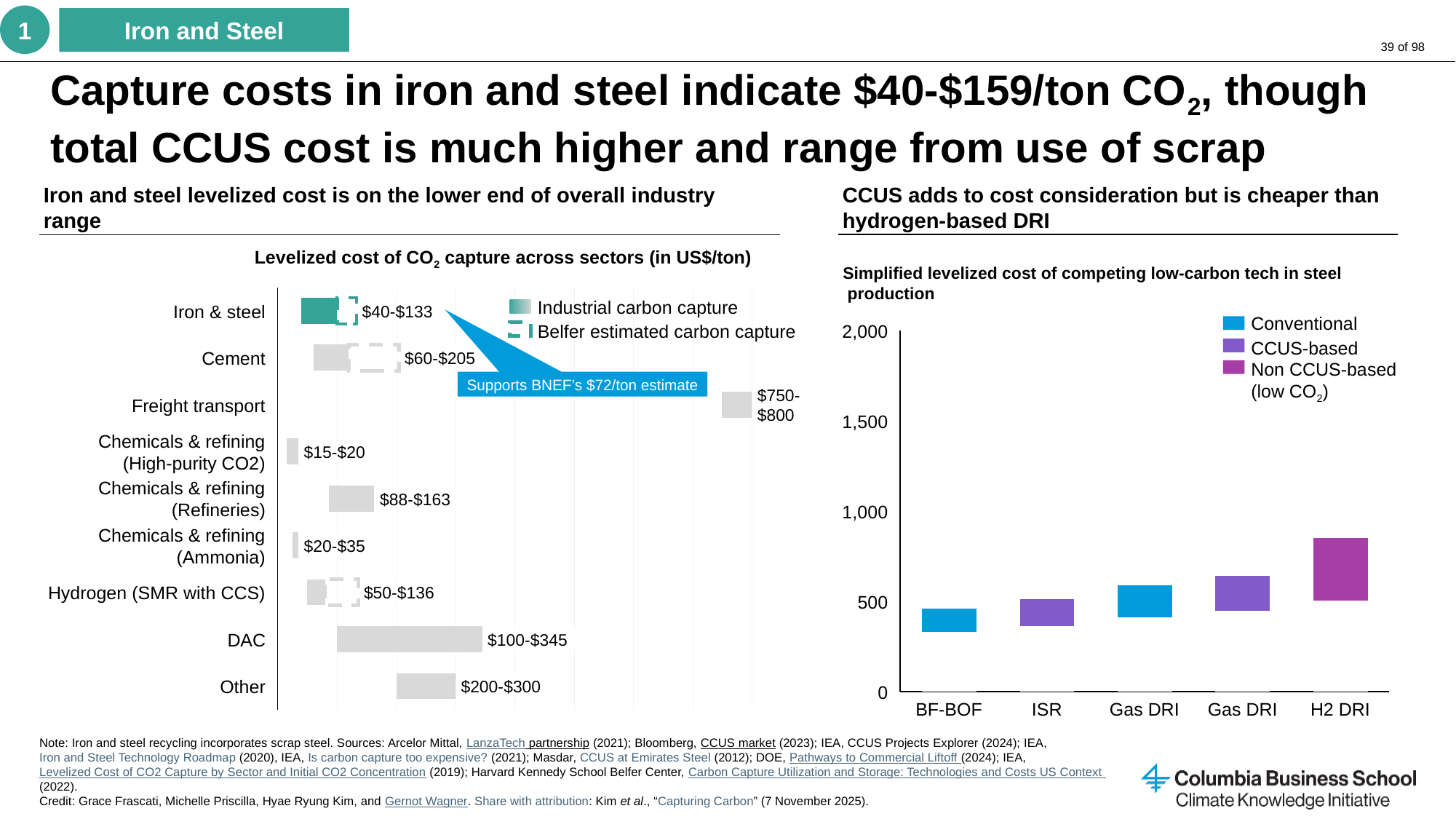
In the left chart, Levelized cost of CO2 capture across sectors, what is the cost range shown for Iron & steel? $40-$133 In the left chart, Levelized cost of CO2 capture across sectors, which sector has the lowest capture cost range? Chemicals & refining (High-purity CO2) In the right chart, Simplified levelized cost of competing low-carbon tech in steel production, how many technologies are shown on the x axis? 5 In the left chart, Levelized cost of CO2 capture across sectors, how many sectors are listed on the vertical axis? 9 In the left chart, Levelized cost of CO2 capture across sectors, what is the cost range shown for Freight transport? $750-$800 In the right chart, Simplified levelized cost of competing low-carbon tech in steel production, which technology has the highest cost? H2 DRI In the right chart, Simplified levelized cost of competing low-carbon tech in steel production, is the upper end of the H2 DRI bar greater or less than 1,000? less What kind of chart is the left chart, Levelized cost of CO2 capture across sectors? Bar chart In the left chart, Levelized cost of CO2 capture across sectors, which sector has the highest capture cost range? Freight transport In the left chart, Levelized cost of CO2 capture across sectors, what is the cost range shown for DAC? $100-$345 In the right chart, Simplified levelized cost of competing low-carbon tech in steel production, how many entries does the legend list? 3 In the left chart, Levelized cost of CO2 capture across sectors, how many entries does the legend list? 2